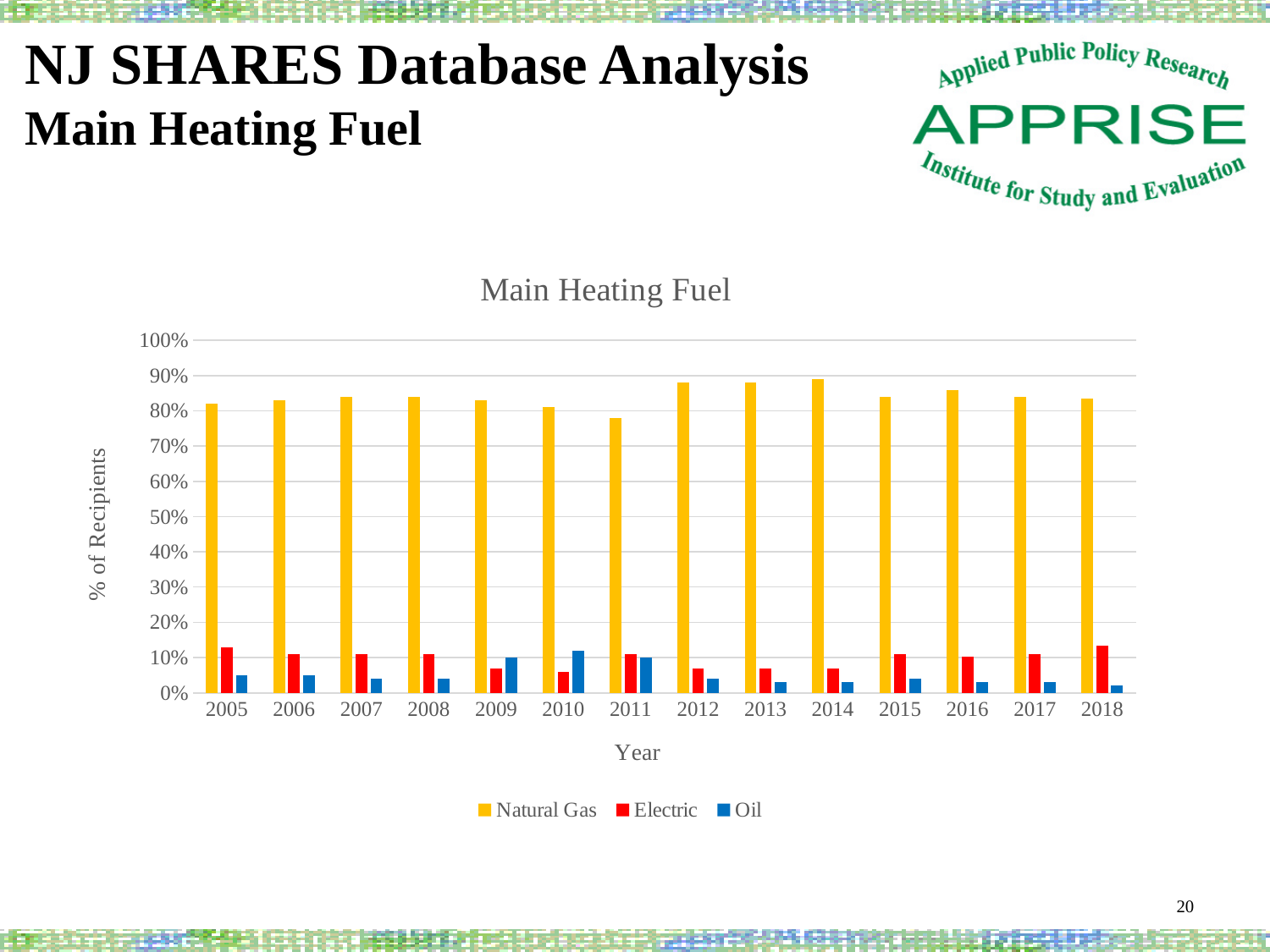
How many series does the legend list? 3 Is the Oil value for 2010 greater or less than 10%? greater How many years are shown on the x axis? 14 Is the Natural Gas value for 2014 greater or less than 80%? greater What is the title of the chart? Main Heating Fuel Which is larger, the Natural Gas value for 2012 or for 2011? 2012 What is the label on the y axis? % of Recipients Which year has the lowest Natural Gas value? 2011 In 2005, which is larger, Electric or Oil? Electric Is the Natural Gas value for 2011 greater or less than 80%? less What kind of chart is shown on the slide? bar chart